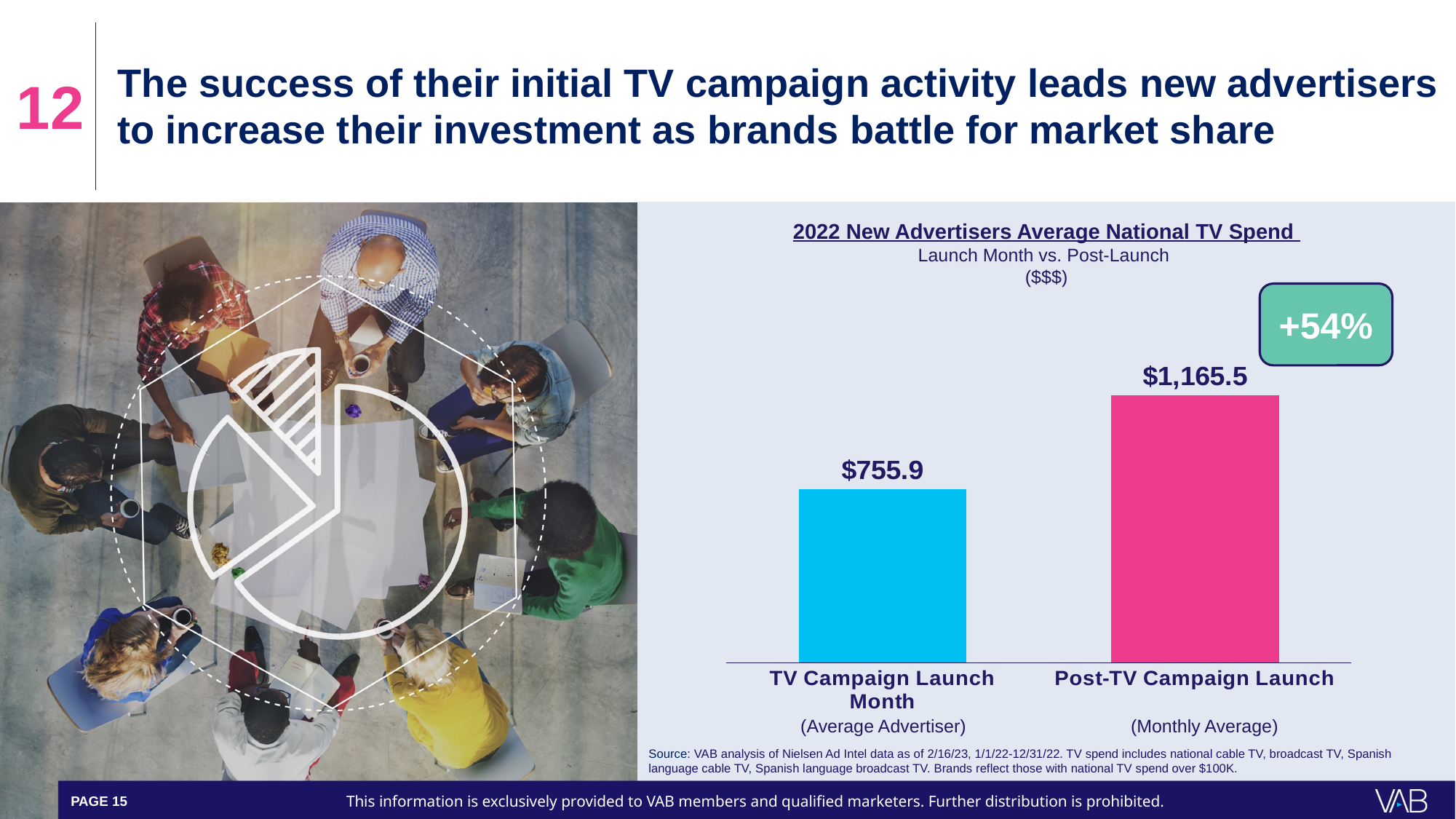
What is the average national TV spend for Post-TV Campaign Launch? $1,165.5 Which category has the higher average national TV spend? Post-TV Campaign Launch Which category has the lower average national TV spend? TV Campaign Launch Month What is the average national TV spend for the TV Campaign Launch Month? $755.9 What percentage change is shown in the callout box on the chart? +54% What is the difference between the Post-TV Campaign Launch spend and the TV Campaign Launch Month spend? $409.6 How many categories are shown in the chart? 2 What kind of chart is shown on the slide? bar chart Is the spend for TV Campaign Launch Month larger or smaller than the spend for Post-TV Campaign Launch? smaller What is the title of the chart? 2022 New Advertisers Average National TV Spend Do the values rise or fall from the launch month to post-launch? rise